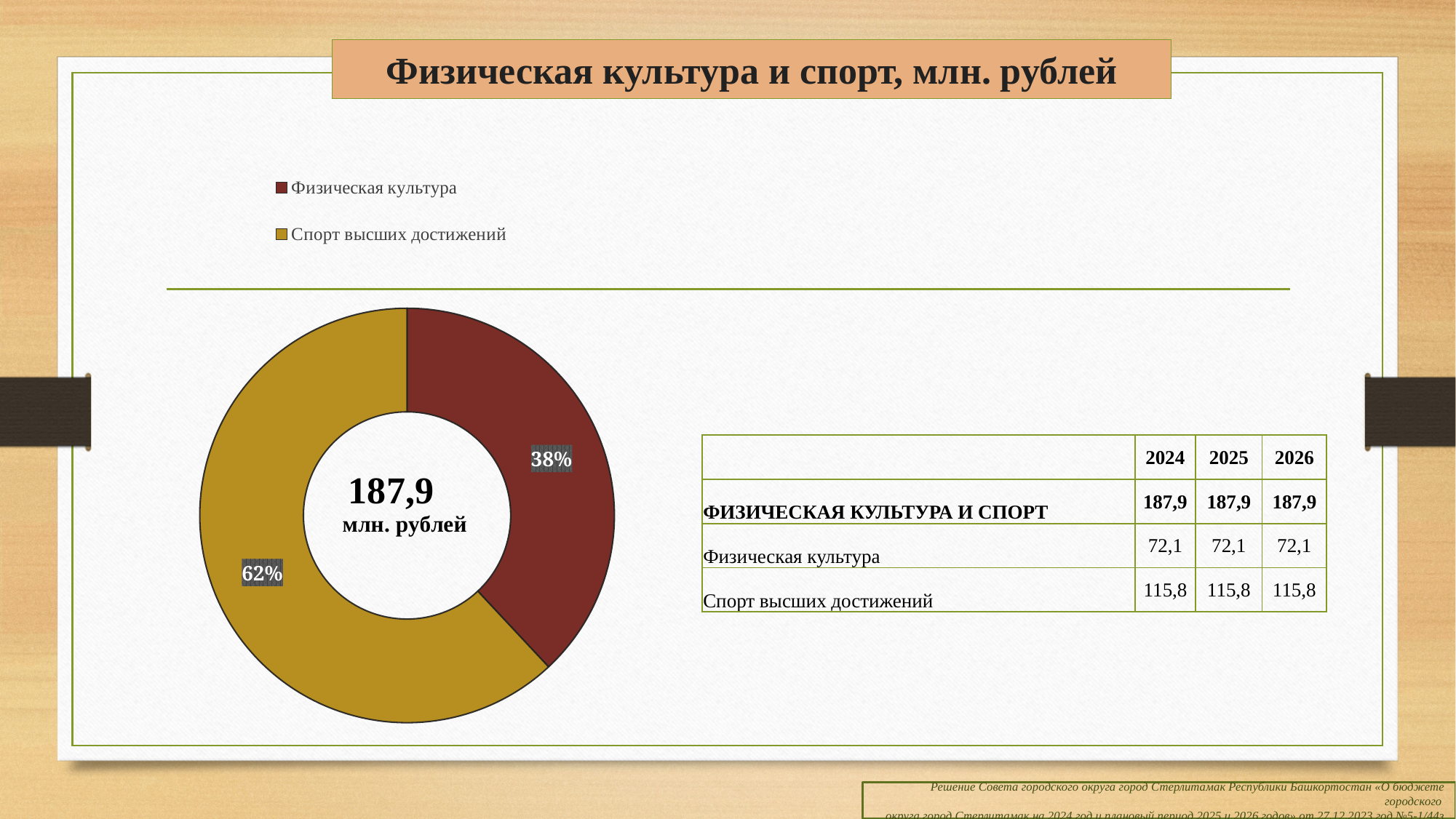
What is the difference in percentage points between the Спорт высших достижений slice and the Физическая культура slice? 24 percentage points Which slice of the doughnut chart is the smallest? Физическая культура What total value is printed in the centre of the doughnut chart? 187,9 млн. рублей Which slice of the doughnut chart is the largest? Спорт высших достижений What is the title of the slide containing the doughnut chart? Физическая культура и спорт, млн. рублей What colour is the Спорт высших достижений slice in the doughnut chart? gold (yellow-brown) Which is larger in the doughnut chart: Физическая культура or Спорт высших достижений? Спорт высших достижений How many slices does the doughnut chart have? 2 What share of the doughnut chart does Физическая культура take? 38% What kind of chart is shown on the slide? doughnut (pie) chart How many entries does the chart legend list? 2 What share of the doughnut chart does Спорт высших достижений take? 62%